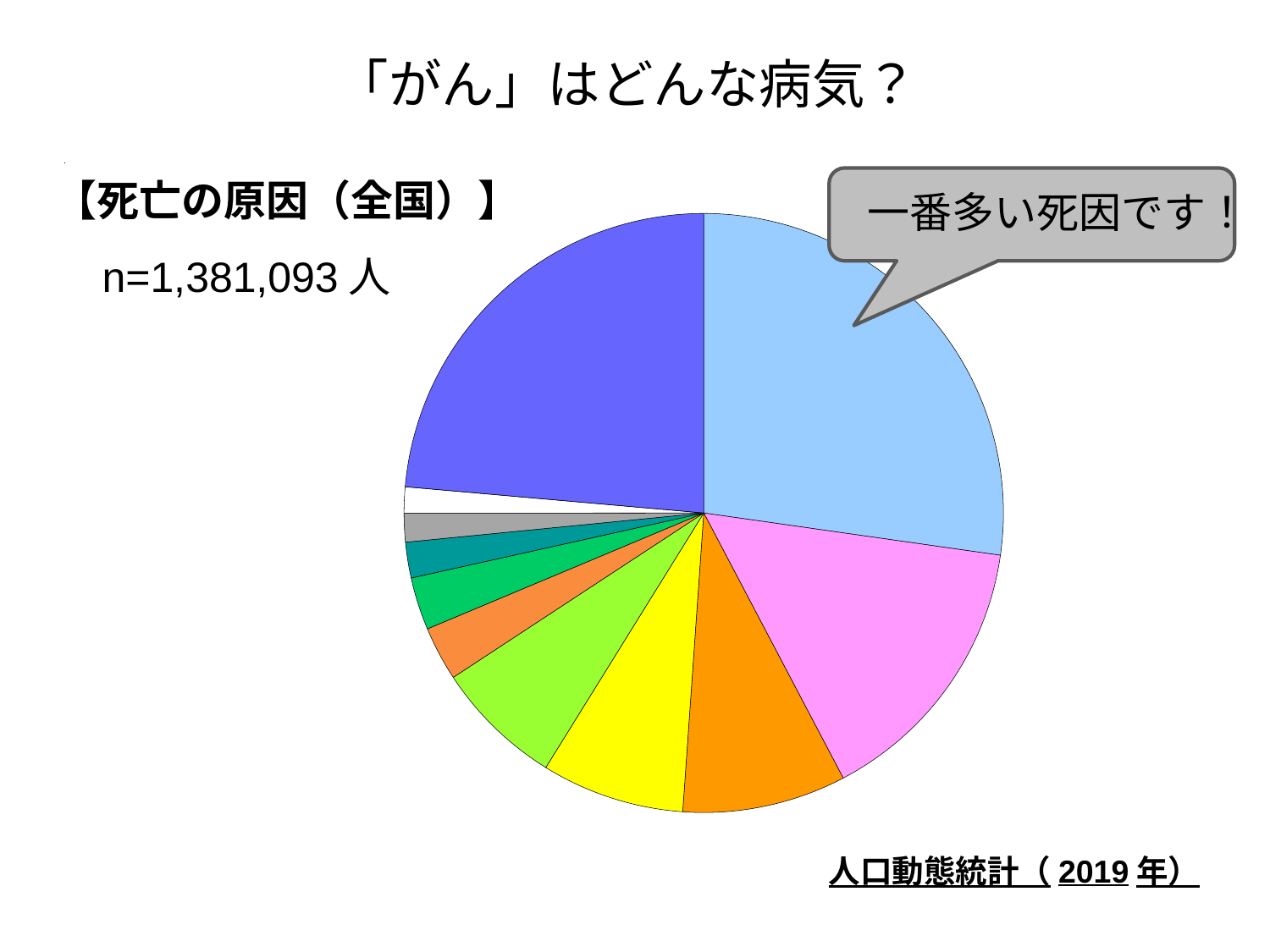
Which slice is larger, the light blue slice or the pink slice? the light blue slice Which slice of the pie chart is the smallest? the white slice Which slice is larger, the yellow slice or the white slice? the yellow slice How many slices does the pie chart have? 11 What is the total number of people (n) shown for the pie chart? n=1,381,093 人 Which slice is larger, the pink slice or the orange slice? the pink slice What is the title of the pie chart? 【死亡の原因（全国）】 According to the callout, which slice of the pie chart represents the most common cause of death? the light blue slice What kind of chart is shown on the slide? pie chart